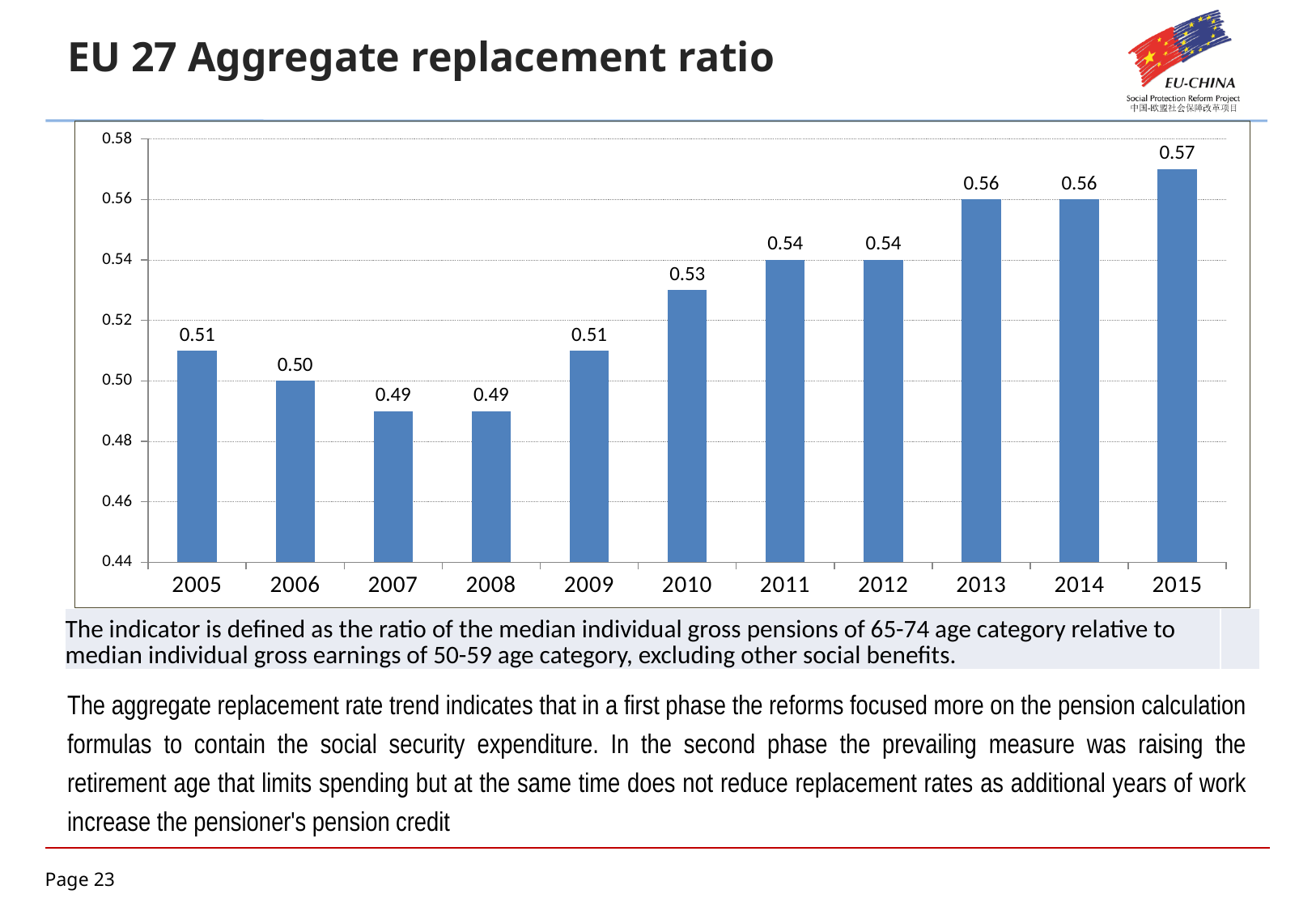
What is the title of the slide containing the chart? EU 27 Aggregate replacement ratio What is the value shown for 2015? 0.57 Which year has the highest aggregate replacement ratio? 2015 Do the values generally rise or fall from 2008 to 2015? rise What is the aggregate replacement ratio for 2005? 0.51 What kind of chart is shown on the slide? bar chart Is the value for 2013 greater or less than 0.54? greater How many years are shown on the x axis? 11 What is the aggregate replacement ratio for 2010? 0.53 What is the difference between the values for 2015 and 2007? 0.08 What is the lowest value shown in the chart? 0.49 Which is larger, the value for 2009 or the value for 2011? 2011